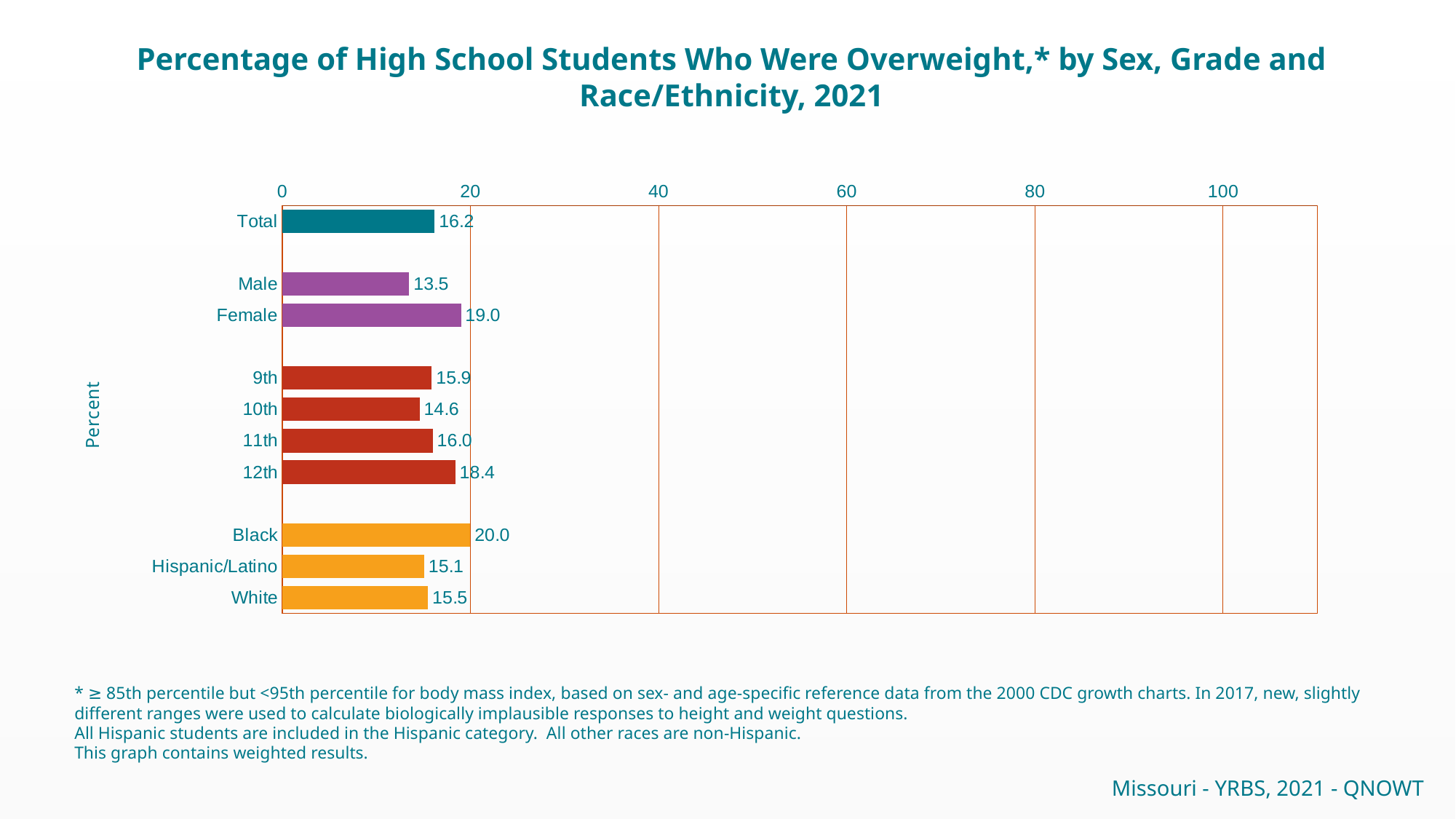
What is the difference between the Female and Male values? 5.5 What is the value for 12th grade? 18.4 What kind of chart is shown on the slide? bar chart What is the value for Hispanic/Latino? 15.1 Is the value for Black greater or less than 40? less How many categories are shown in the chart? 11 What is the value for Total? 16.2 What is the value for Female? 19.0 What is the label on the vertical axis? Percent Which category has the lowest value? Male Which is larger, the value for 9th grade or 10th grade? 9th Which category has the highest value? Black